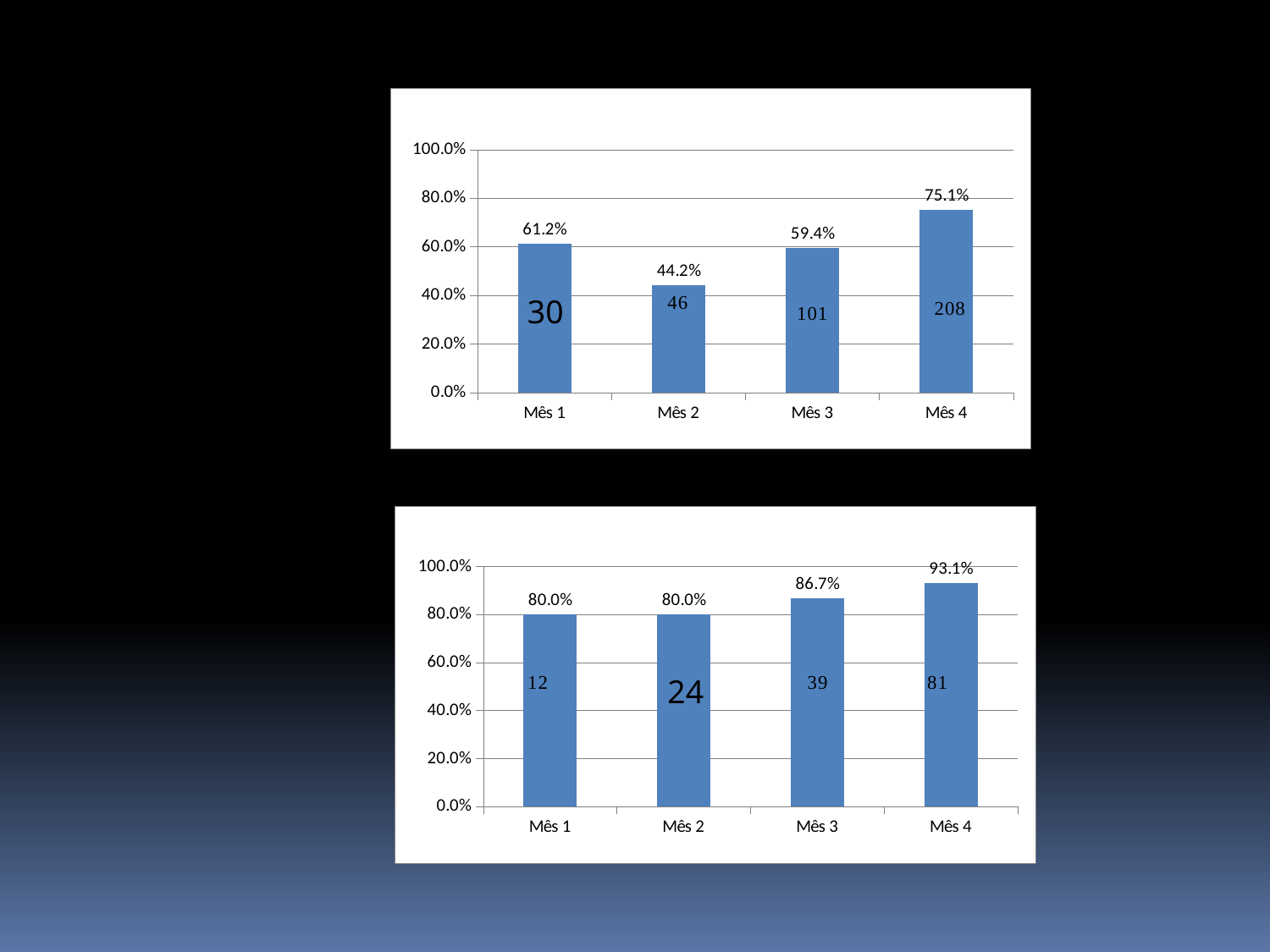
In the top chart, what is the value for Mês 1? 61.2% In the bottom chart, what is the value for Mês 3? 86.7% In the top chart, what is the value for Mês 4? 75.1% In the bottom chart, what is the value for Mês 4? 93.1% In the bottom chart, what is the difference between the values for Mês 4 and Mês 1? 13.1% What kind of chart is the bottom chart? Bar chart In the top chart, which month has the lowest value? Mês 2 In the bottom chart, how many months are shown on the x axis? 4 In the top chart, what is the difference between the values for Mês 4 and Mês 2? 30.9% In the bottom chart, which month has the highest value? Mês 4 In the top chart, what number is printed inside the bar for Mês 3? 101 In the top chart, which month has the highest value? Mês 4